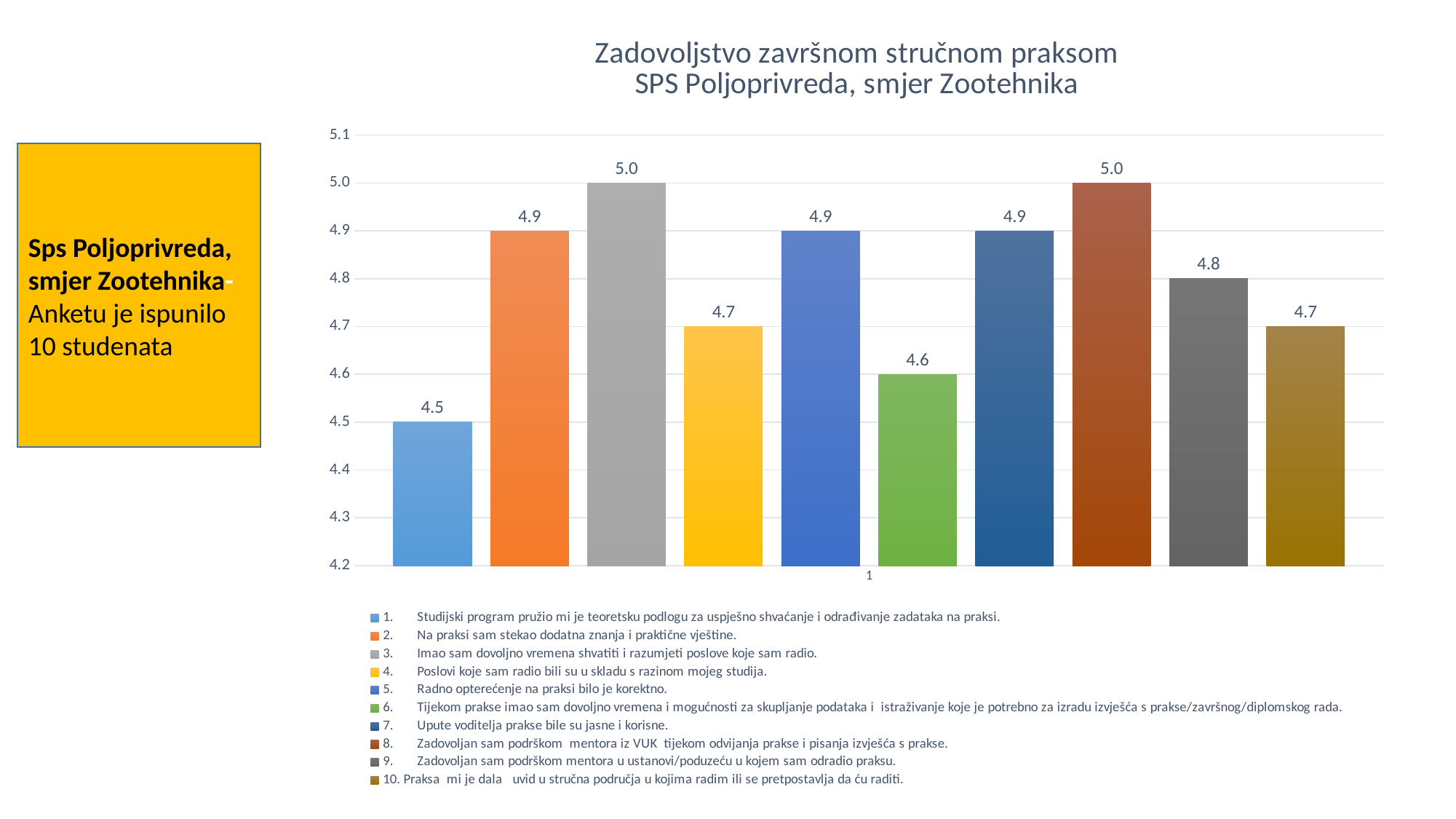
What is the value for series 3, "Imao sam dovoljno vremena shvatiti i razumjeti poslove koje sam radio."? 5.0 What is the difference between the value for series 9 (4.8) and series 10 (4.7)? 0.1 What is the value for series 6, "Tijekom prakse imao sam dovoljno vremena i mogućnosti za skupljanje podataka i istraživanje..."? 4.6 What is the value for series 1, "Studijski program pružio mi je teoretsku podlogu za uspješno shvaćanje i odrađivanje zadataka na praksi."? 4.5 Which is larger, the value for series 4 (Poslovi koje sam radio bili su u skladu s razinom mojeg studija) or series 9 (Zadovoljan sam podrškom mentora u ustanovi/poduzeću)? series 9 (4.8) How many series does the legend list? 10 Which series has the lowest value? 1. Studijski program pružio mi je teoretsku podlogu za uspješno shvaćanje i odrađivanje zadataka na praksi. What is the title of the chart? Zadovoljstvo završnom stručnom praksom SPS Poljoprivreda, smjer Zootehnika What kind of chart is shown on the slide? bar chart What is the difference between the value for series 8 (Zadovoljan sam podrškom mentora iz VUK) and series 1 (Studijski program pružio mi je teoretsku podlogu)? 0.5 Is the value for series 2, "Na praksi sam stekao dodatna znanja i praktične vještine.", greater or less than 4.7? greater What is the value for series 9, "Zadovoljan sam podrškom mentora u ustanovi/poduzeću u kojem sam odradio praksu."? 4.8